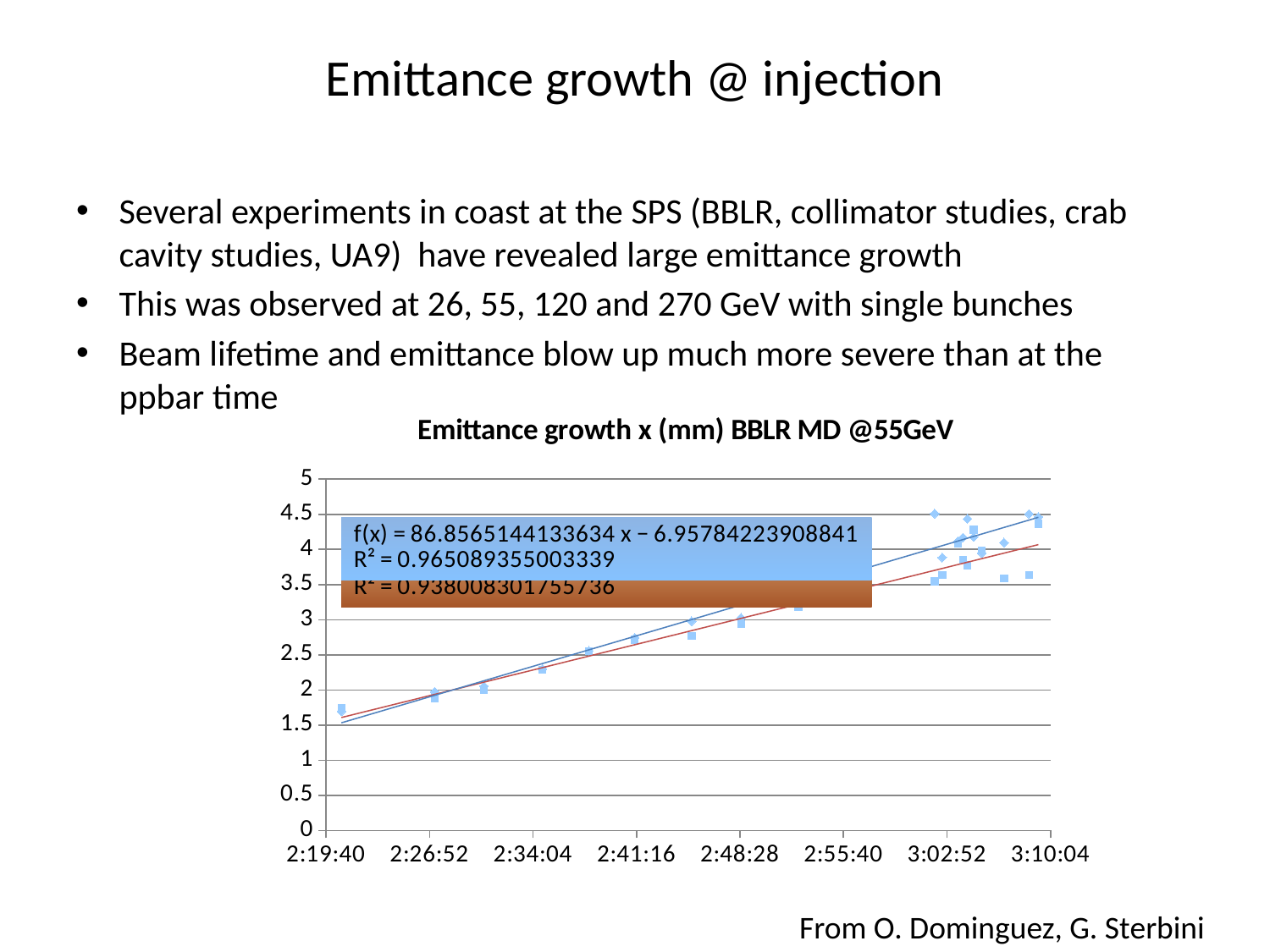
Is the plotted value at 2:48:28 greater or less than 2.5? greater Are the plotted values near 3:10:04 greater or less than 4? greater Do the plotted emittance values rise or fall as time increases along the x axis? rise Is the plotted value at 2:19:40 greater or less than 2? less What is the highest value shown on the y axis? 5 What is the title of the chart? Emittance growth x (mm) BBLR MD @55GeV What is the R² value given for the fit f(x) = 86.8565144133634 x − 6.95784223908841? 0.965089355003339 How many tick labels are shown on the x axis? 8 What kind of chart is shown on the slide? scatter chart Which is larger, the plotted value at 2:19:40 or the plotted value at 2:41:16? 2:41:16